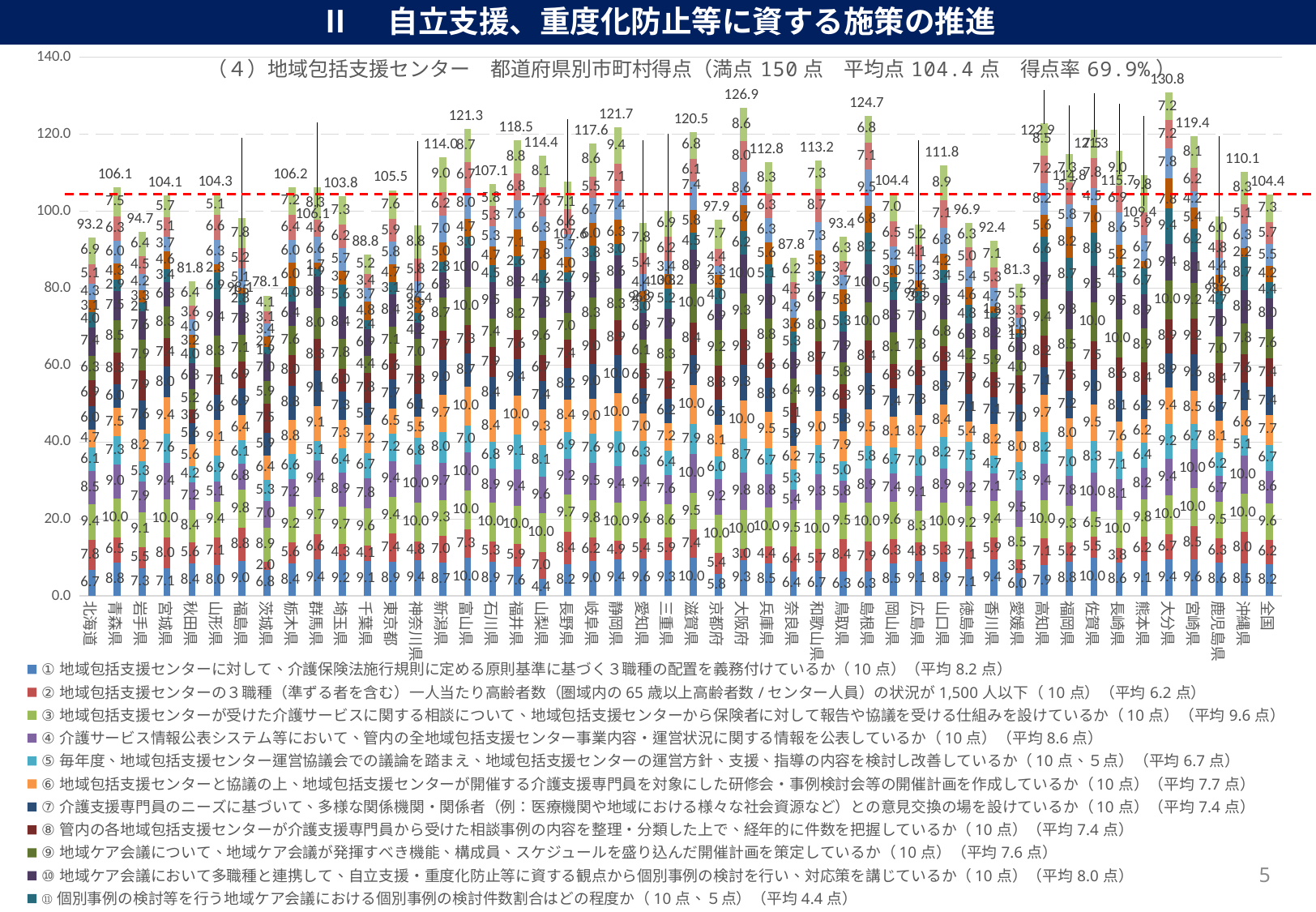
Is the total score for 茨城県 greater or less than 80.0? less How many series does the legend list? 11 What is the total score for 秋田県? 81.8 According to the chart title, what is the average score (平均点)? 104.4 点 What is the total score for 全国? 104.4 What is the total score for 大阪府? 126.9 What is the difference between the total score of 大阪府 and 奈良県? 39.1 What is the difference between the total score of 大分県 and 全国? 26.4 What is the total score for 大分県? 130.8 Which has a higher total score, 富山県 or 石川県? 富山県 What kind of chart is shown on the slide? Stacked bar chart Which prefecture has the highest total score? 大分県